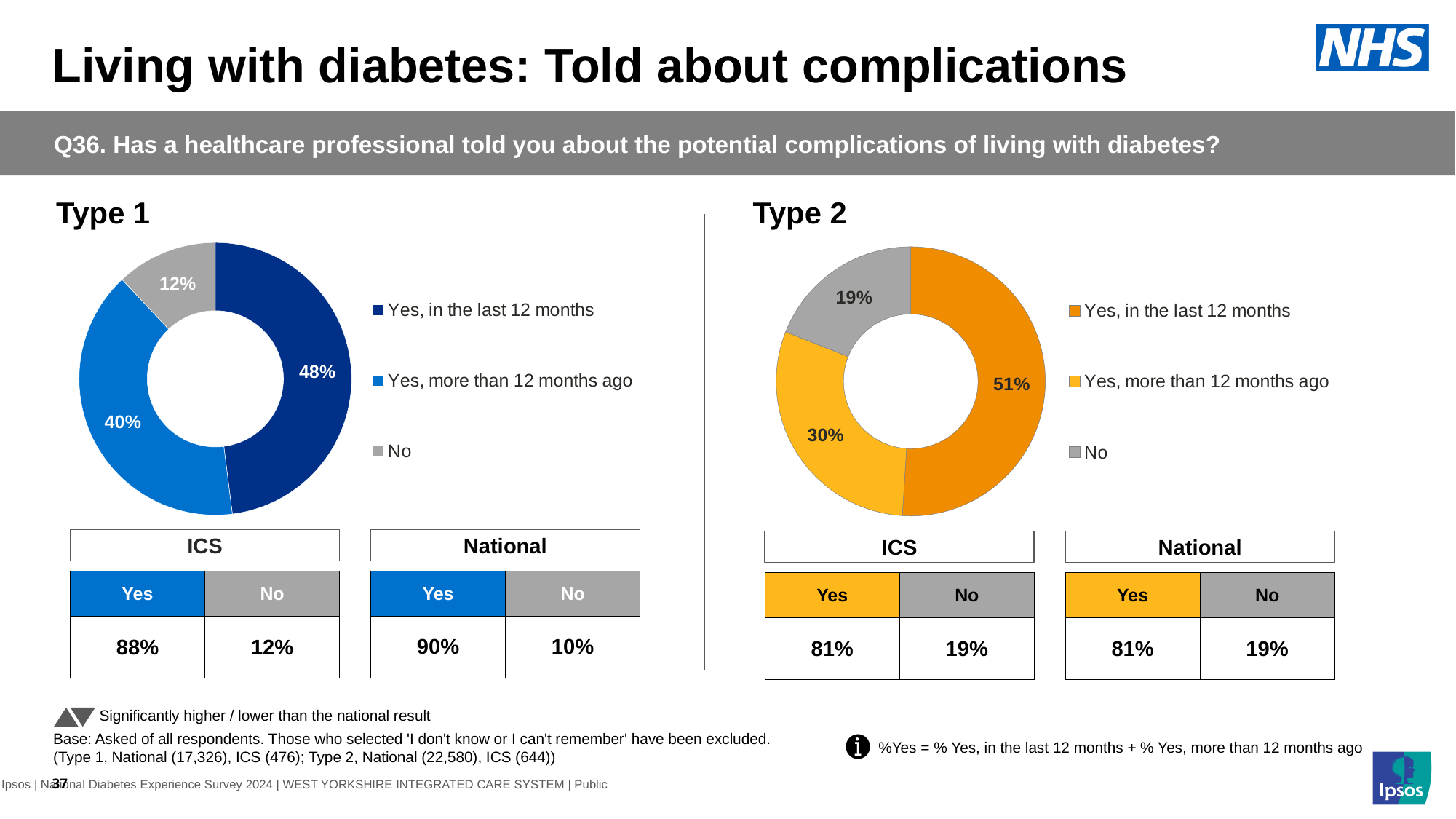
In the Type 1 chart, what is the combined share of the two 'Yes' categories? 88% What colour represents 'No' in both charts? Grey In the Type 2 chart, what percentage of respondents said 'No'? 19% How many categories does the Type 2 chart show? 3 In the Type 2 chart, which category has the largest share? Yes, in the last 12 months In the Type 2 chart, what is the difference between 'Yes, in the last 12 months' and 'Yes, more than 12 months ago'? 21% What kind of chart is used for Type 1? Pie chart (doughnut) In the Type 1 chart, what percentage said 'Yes, more than 12 months ago'? 40% In the Type 1 chart, what percentage of respondents said 'Yes, in the last 12 months'? 48% In the Type 1 chart, which category has the smallest share? No Which is larger in the Type 1 chart: 'Yes, more than 12 months ago' or 'No'? Yes, more than 12 months ago What is the difference between the Type 1 and Type 2 'No' shares? 7%